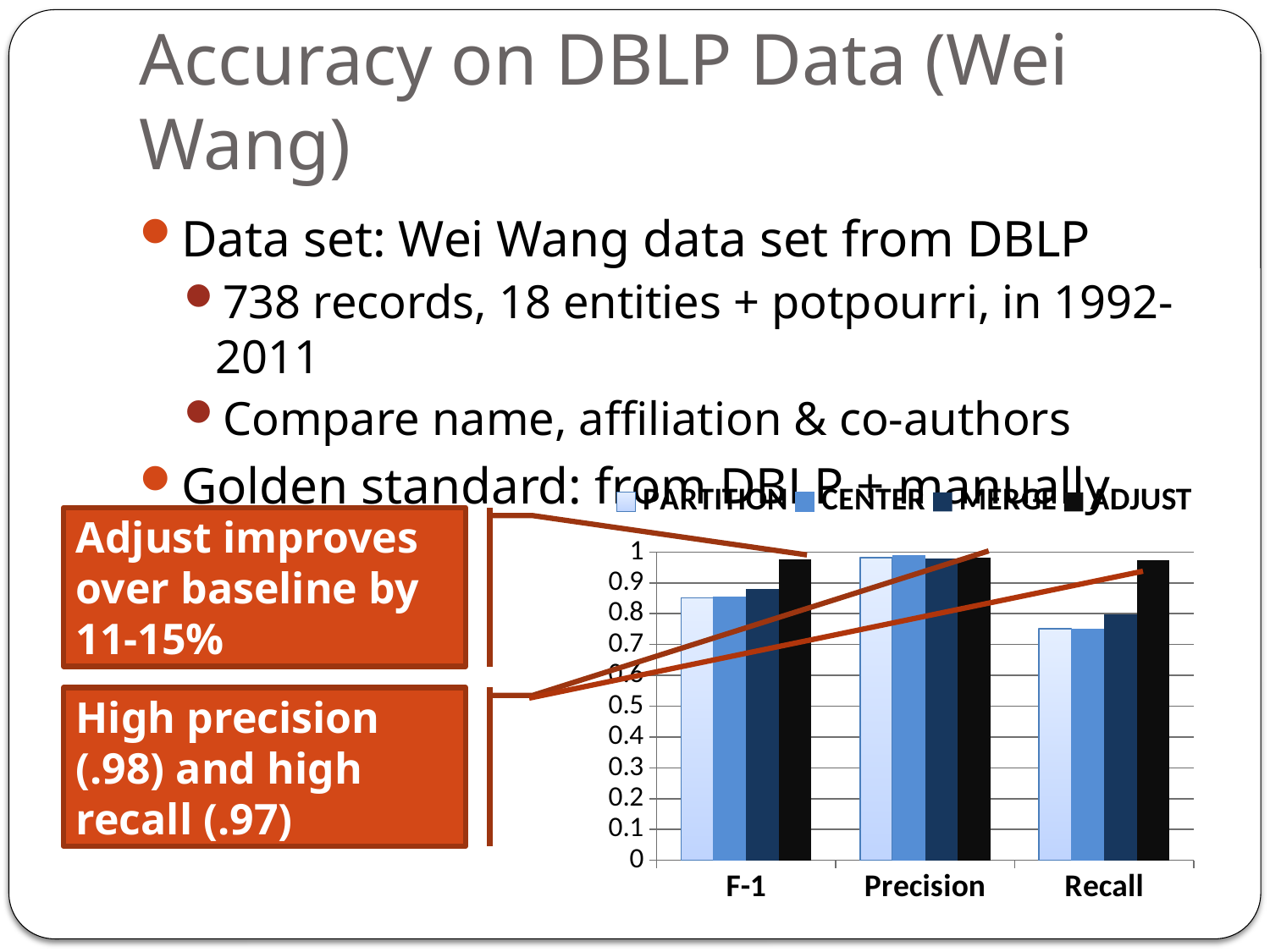
Which series has the highest value for Recall? ADJUST Is the PARTITION value for Recall greater or less than 0.8? less Is the ADJUST value for F-1 greater or less than 0.9? greater Which series has the highest value for F-1? ADJUST For F-1, which is larger: the PARTITION value or the ADJUST value? ADJUST For Recall, which is larger: the MERGE value or the ADJUST value? ADJUST Which series is shown in black in the chart? ADJUST What are the three categories on the x axis of the chart? F-1, Precision, Recall What kind of chart is shown on the slide? bar chart How many categories are shown on the x axis of the chart? 3 Is the PARTITION value for Precision greater or less than 0.9? greater How many series does the chart's legend list? 4